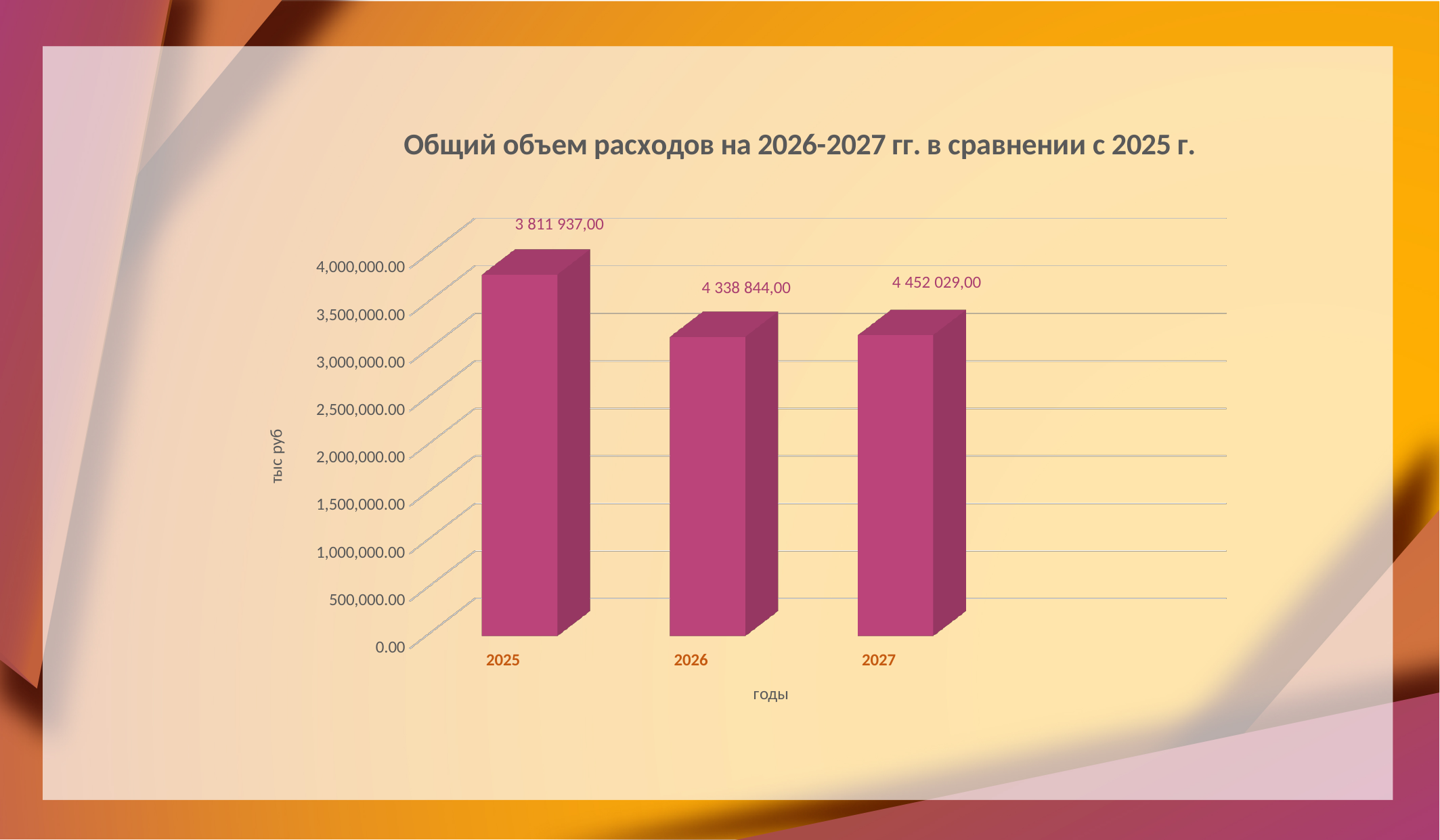
What is the label of the vertical axis? тыс руб What is the value for 2026? 4 338 844,00 What is the difference between the labelled values for 2026 and 2025? 526 907,00 How many years are shown on the x axis? 3 What kind of chart is shown on the slide? bar chart What is the difference between the labelled values for 2027 and 2026? 113 185,00 Is the value for 2025 greater or less than 4,000,000.00? less What is the value for 2027? 4 452 029,00 What is the value for 2025? 3 811 937,00 What is the difference between the labelled values for 2027 and 2025? 640 092,00 What is the title of the chart? Общий объем расходов на 2026-2027 гг. в сравнении с 2025 г. Is the value for 2025 greater or less than 3,000,000.00? greater